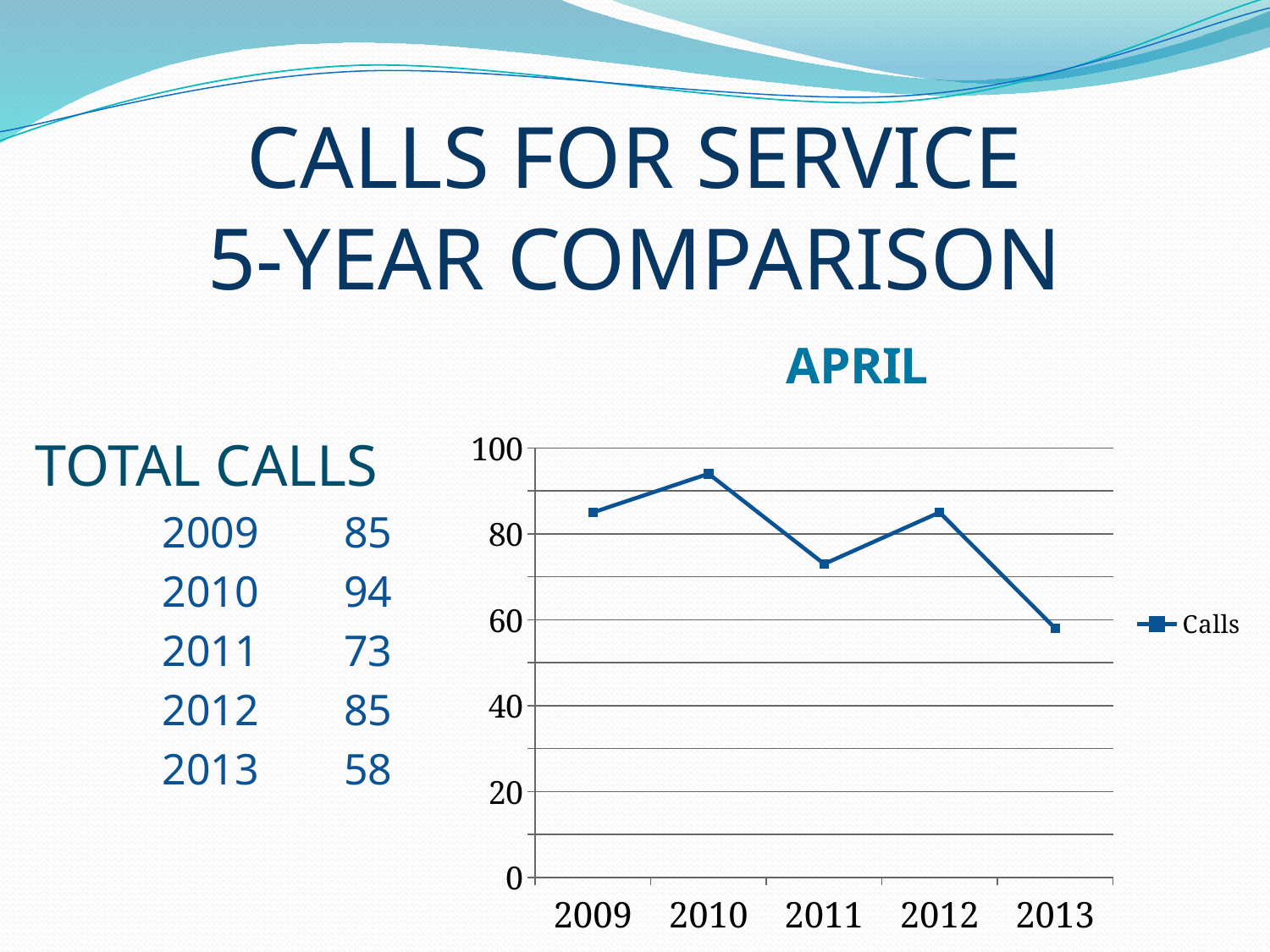
What is the number of calls for 2011? 73 What type of chart is shown on the slide? line chart What is the title shown above the chart? APRIL Which year has the highest number of calls? 2010 Which year had more calls, 2011 or 2012? 2012 What is the number of calls for 2010? 94 What is the difference in calls between 2010 and 2013? 36 Is the value for 2013 greater or less than 60? less How many series does the legend list? 1 What is the number of calls for 2013? 58 Which year has the lowest number of calls? 2013 How many years are plotted on the x axis? 5